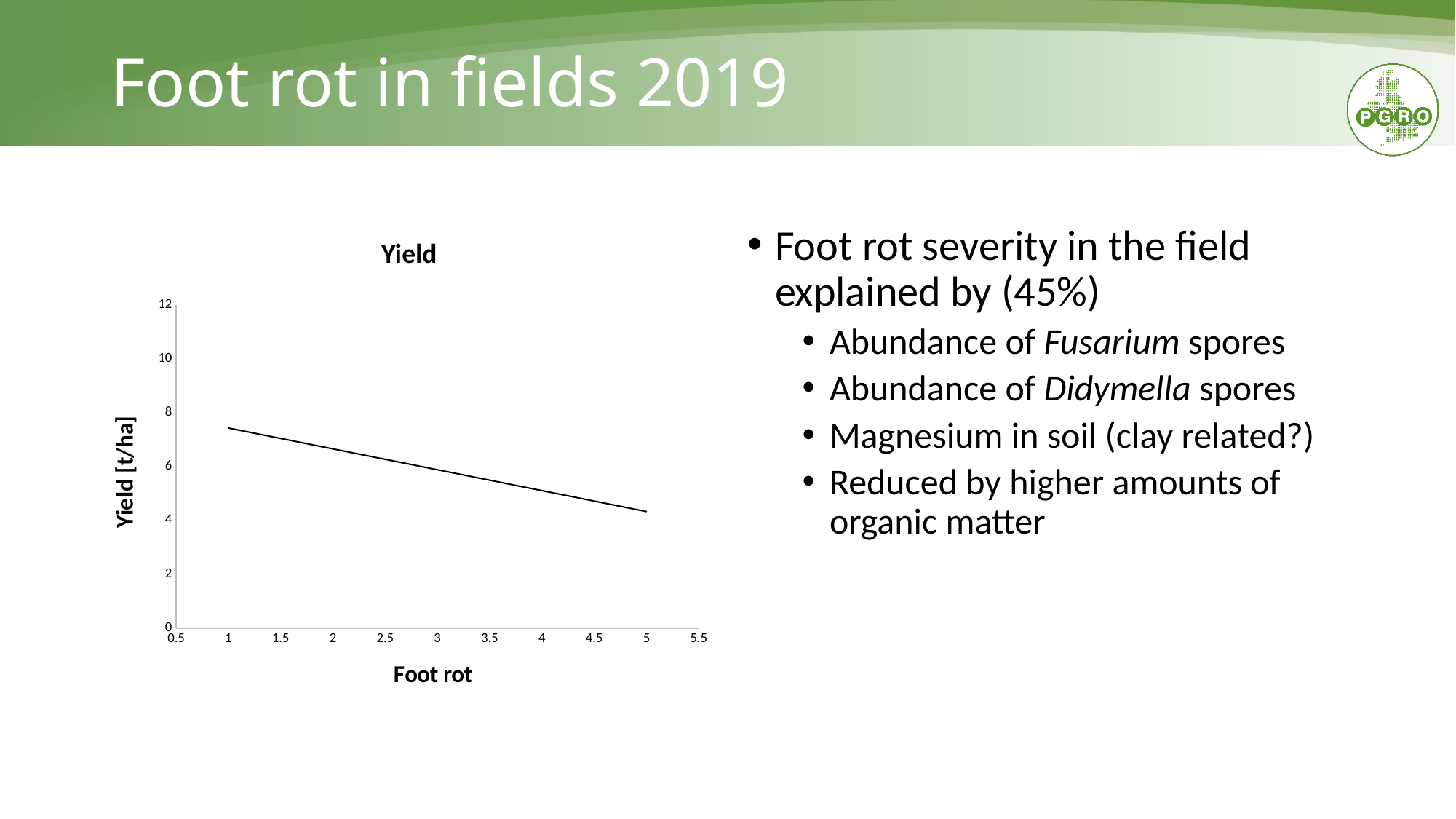
Which is larger, the yield at a foot rot value of 1 or at a foot rot value of 5? foot rot value of 1 Is the yield at a foot rot value of 3 greater or less than 8? less What is the title of the chart? Yield What kind of chart is shown on the slide? line chart Is the yield at a foot rot value of 1 greater or less than 6? greater Is the yield at a foot rot value of 5 greater or less than 6? less What is the highest value shown on the y axis of the chart? 12 What is the label of the y axis of the chart? Yield [t/ha] As foot rot increases along the x axis, does yield rise or fall? fall